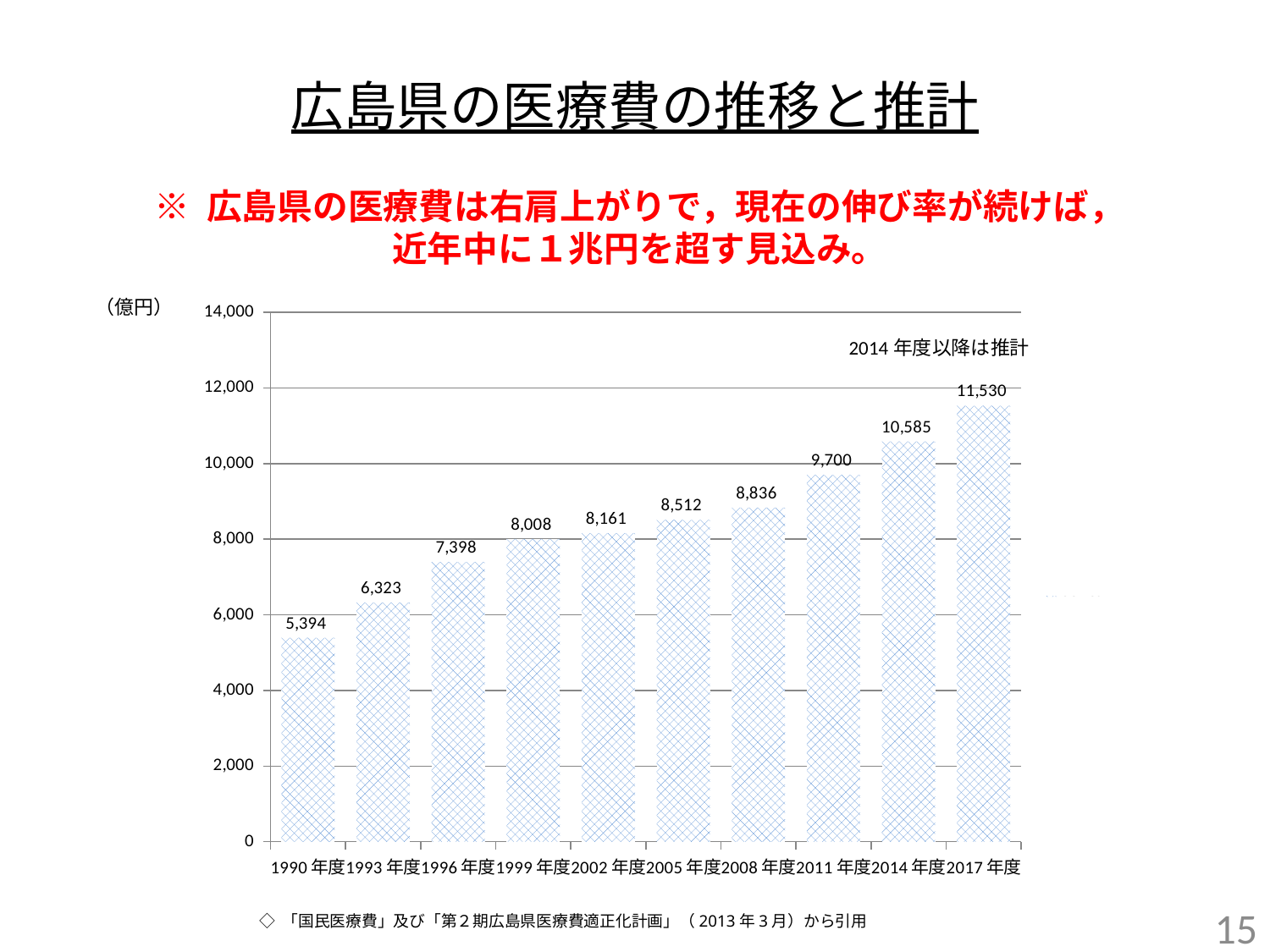
Do the values rise or fall from 1990年度 to 2017年度? rise Which year has the lowest value? 1990年度 Is the value for 2011年度 greater or less than 10,000? less What kind of chart is shown on the slide? bar chart What is the value for 2005年度? 8,512 What is the difference between the values for 2017年度 and 2014年度? 945 What is the value for 2014年度? 10,585 What is the difference between the values for 1993年度 and 1990年度? 929 Which is larger, the value for 2002年度 or the value for 1999年度? 2002年度 How many bars are shown in the chart? 10 What is the value for 1990年度? 5,394 Which year has the highest value? 2017年度